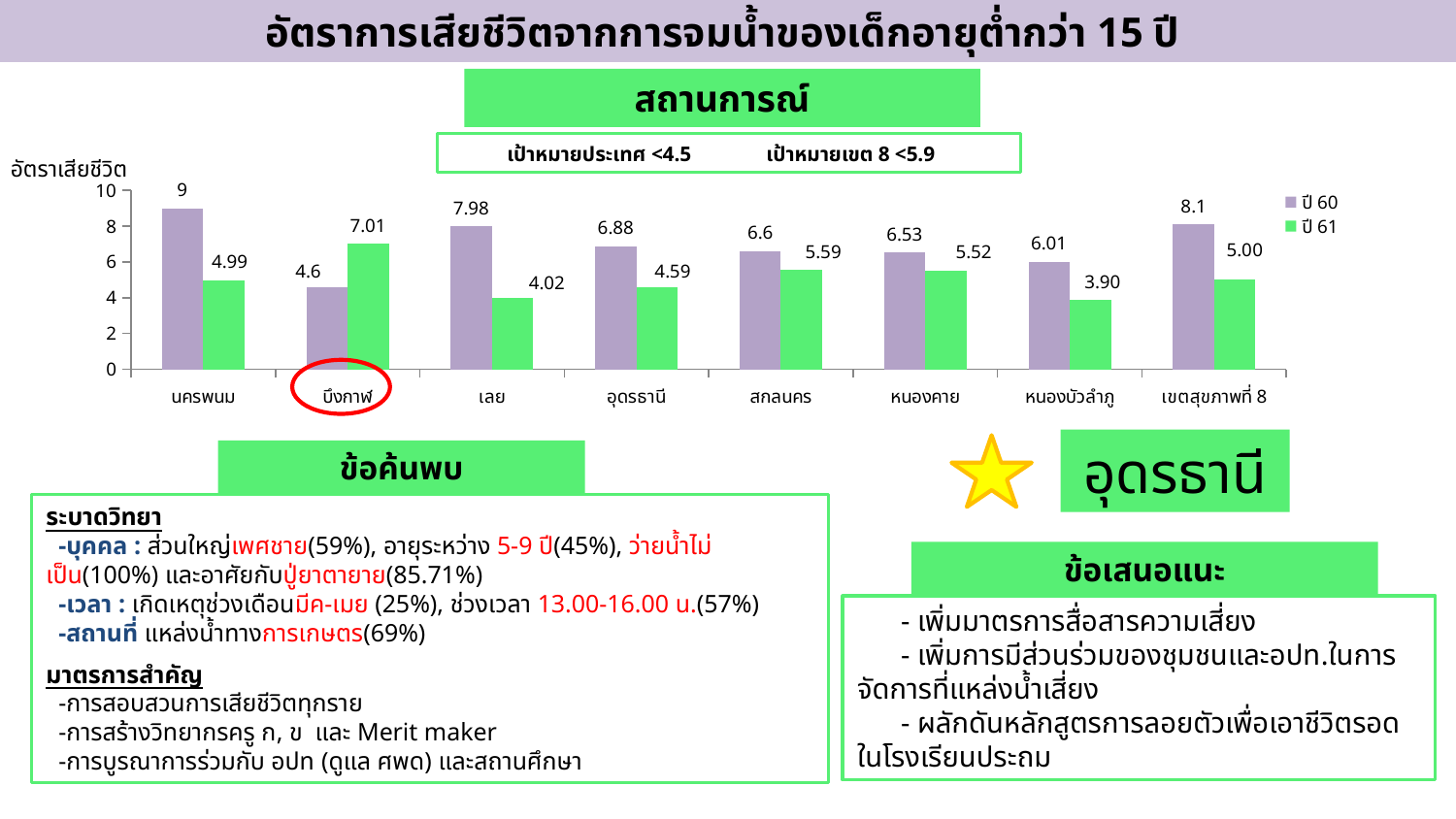
What is the value for ปี 60 in นครพนม? 9 How many categories are shown on the x axis? 8 In บึงกาฬ, which series has the larger value, ปี 60 or ปี 61? ปี 61 What is the value for ปี 61 in หนองบัวลำภู? 3.90 What kind of chart is shown on the slide? bar chart Which category has the lowest value for ปี 61? หนองบัวลำภู Which category on the x axis is circled in red? บึงกาฬ Which category has the highest value for ปี 60? นครพนม What is the difference between the ปี 60 and ปี 61 values in เลย? 3.96 What is the value for ปี 60 in เขตสุขภาพที่ 8? 8.1 What is the value for ปี 61 in บึงกาฬ? 7.01 How many series does the legend list? 2